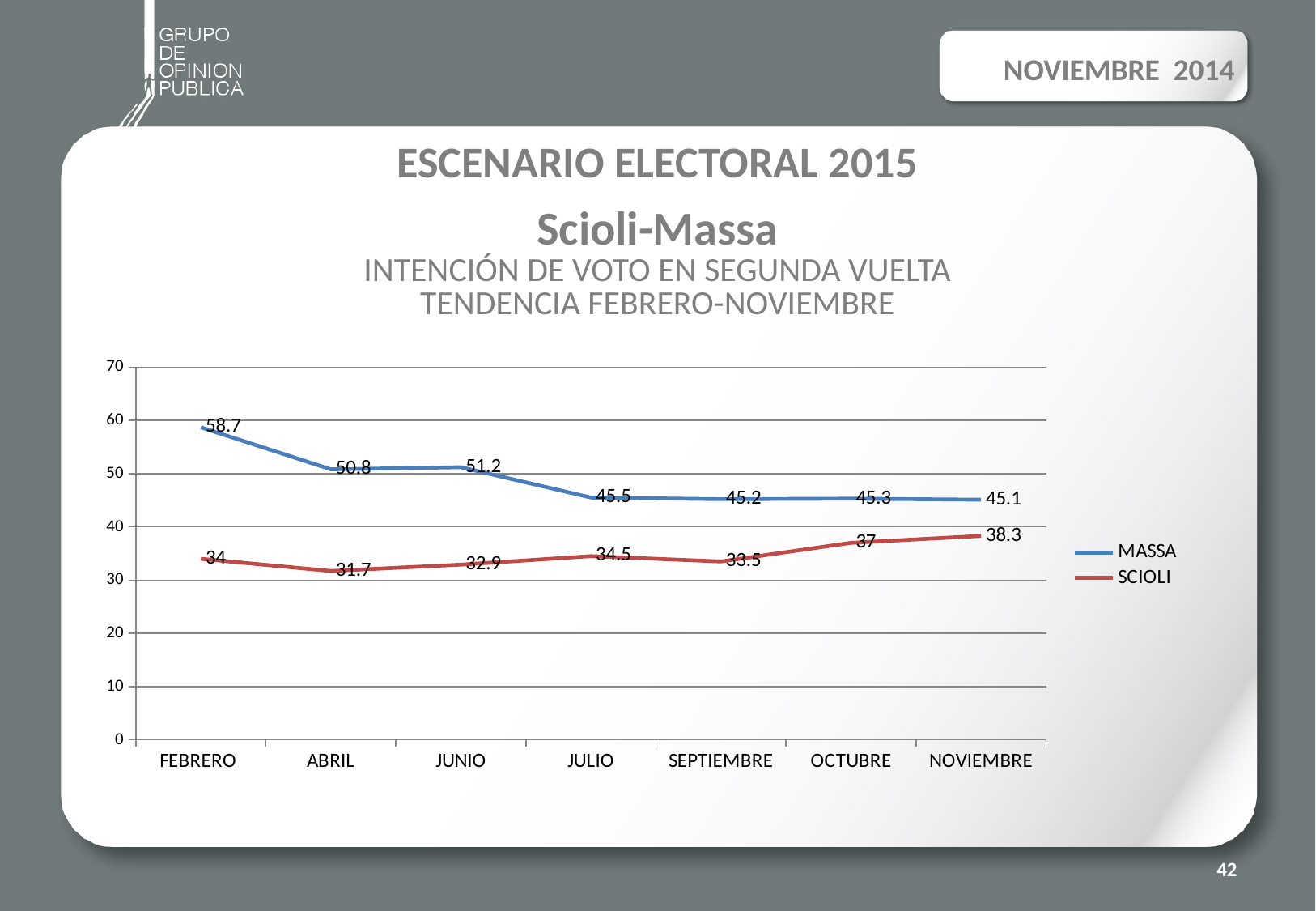
In which month is the MASSA series highest? FEBRERO In which month is the SCIOLI series lowest? ABRIL Is the value for SCIOLI in OCTUBRE greater or less than 40? less What kind of chart is shown on the slide? line chart How many series does the legend list? 2 Does the MASSA series rise or fall from FEBRERO to NOVIEMBRE? fall What is the value for MASSA in FEBRERO? 58.7 Which series has the larger value in JULIO, MASSA or SCIOLI? MASSA What is the difference between MASSA and SCIOLI in NOVIEMBRE? 6.8 How many months are shown on the x axis? 7 What is the value for SCIOLI in NOVIEMBRE? 38.3 What is the value for SCIOLI in ABRIL? 31.7